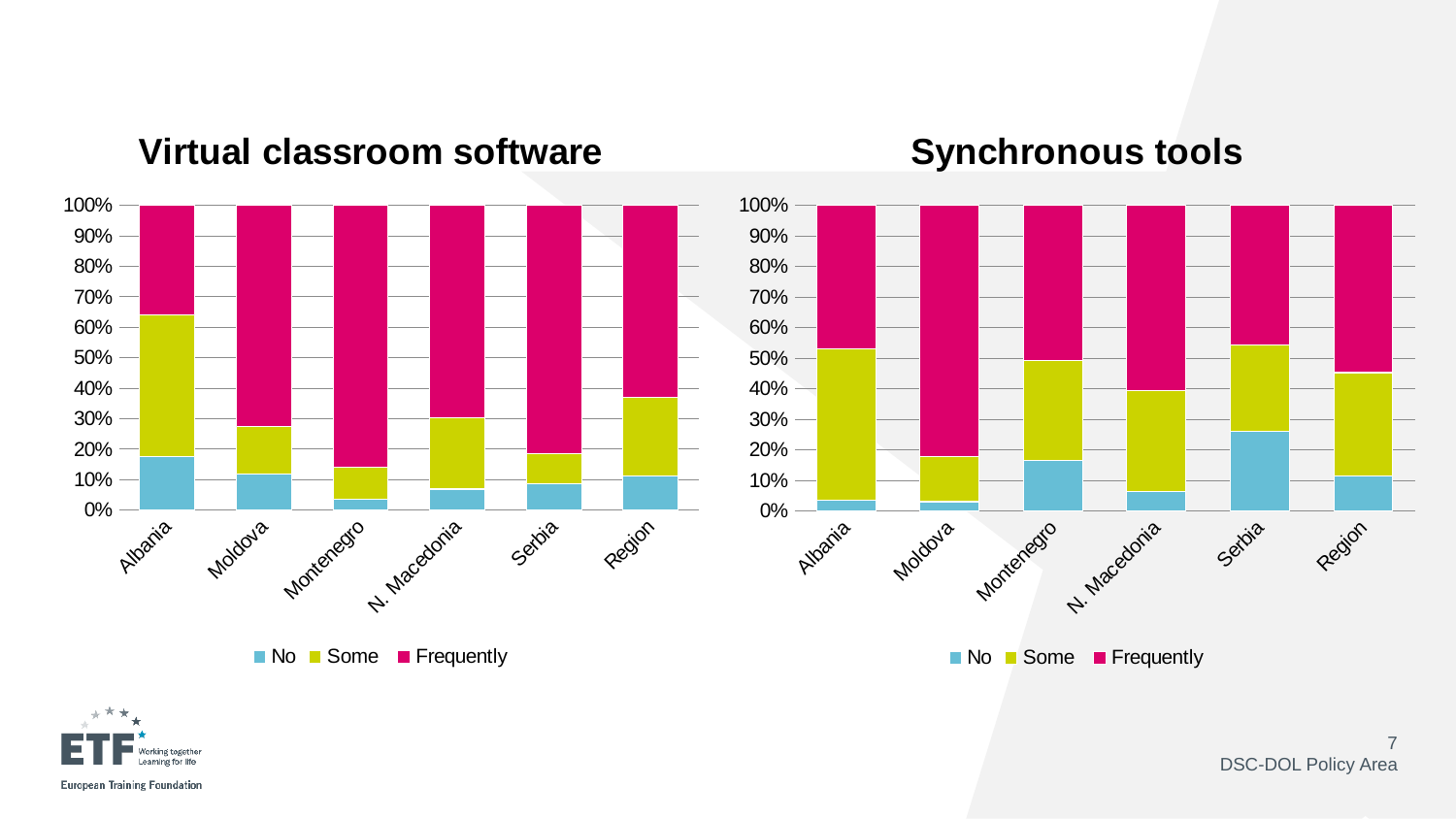
In the 'Virtual classroom software' chart, is the 'No' share larger for Albania or for Montenegro? Albania What type of chart is the 'Virtual classroom software' chart? Stacked bar chart In the 'Synchronous tools' chart, is the 'No' share for Albania greater or less than 10%? less How many categories are shown on the x axis of the 'Synchronous tools' chart? 6 How many series does the legend of the 'Virtual classroom software' chart list? 3 In the 'Virtual classroom software' chart, is the 'No' share for Albania greater or less than 10%? greater What are the three legend entries of the 'Synchronous tools' chart? No, Some, Frequently In the 'Virtual classroom software' chart, is the 'No' share for Montenegro greater or less than 10%? less In the 'Synchronous tools' chart, which category has the largest 'No' share? Serbia In the 'Virtual classroom software' chart, which category has the smallest 'No' share? Montenegro In the 'Virtual classroom software' chart, which category has the largest 'No' share? Albania